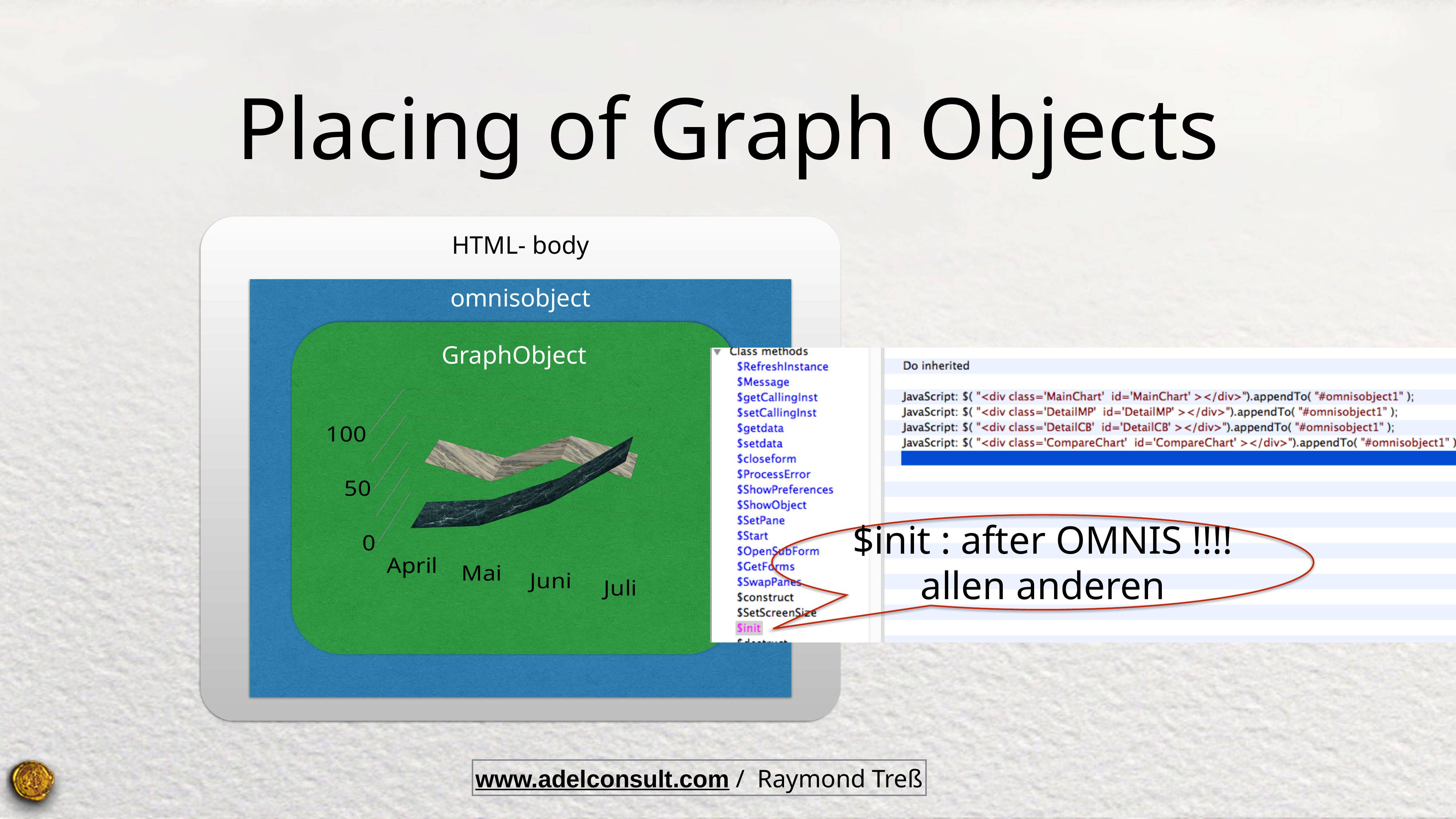
What is the lowest tick value shown on the vertical axis of the chart? 0 What is the highest tick value shown on the vertical axis of the chart? 100 Does the dark lower line rise or fall from April to Juli? rise Which category comes between Mai and Juli on the x axis? Juni What is the last category on the x axis of the chart? Juli What is the first category on the x axis of the chart? April How many categories are shown on the x axis of the chart? 4 How many lines (ribbons) are plotted in the chart? 2 What kind of chart is shown inside the GraphObject area? line chart